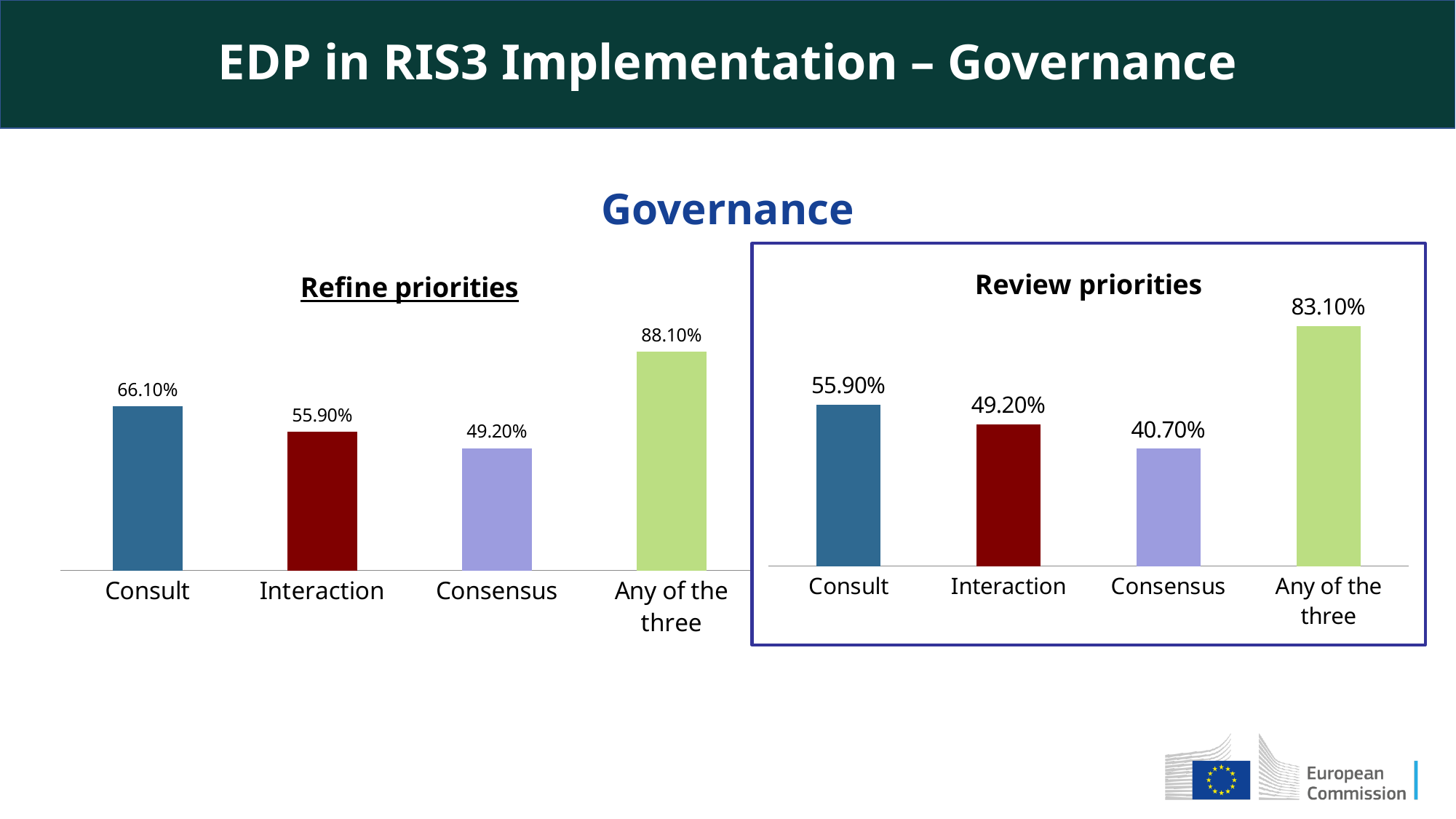
In the Review priorities chart, what is the value for Consensus? 40.70% In the Refine priorities chart, what is the difference between Any of the three and Consult? 22.00% In the Review priorities chart, what is the value for Interaction? 49.20% In the Review priorities chart, what is the difference between Consult and Consensus? 15.20% In the Review priorities chart, which category has the highest value? Any of the three What type of chart is the Refine priorities chart? Bar chart In the Refine priorities chart, which category has the lowest value? Consensus Which is larger: Interaction in the Refine priorities chart or Interaction in the Review priorities chart? Refine priorities In the Refine priorities chart, what is the value for Consult? 66.10% How many categories does the Review priorities chart show? 4 In the Refine priorities chart, what is the value for Any of the three? 88.10% In the Refine priorities chart, what colour is the Interaction bar? Dark red